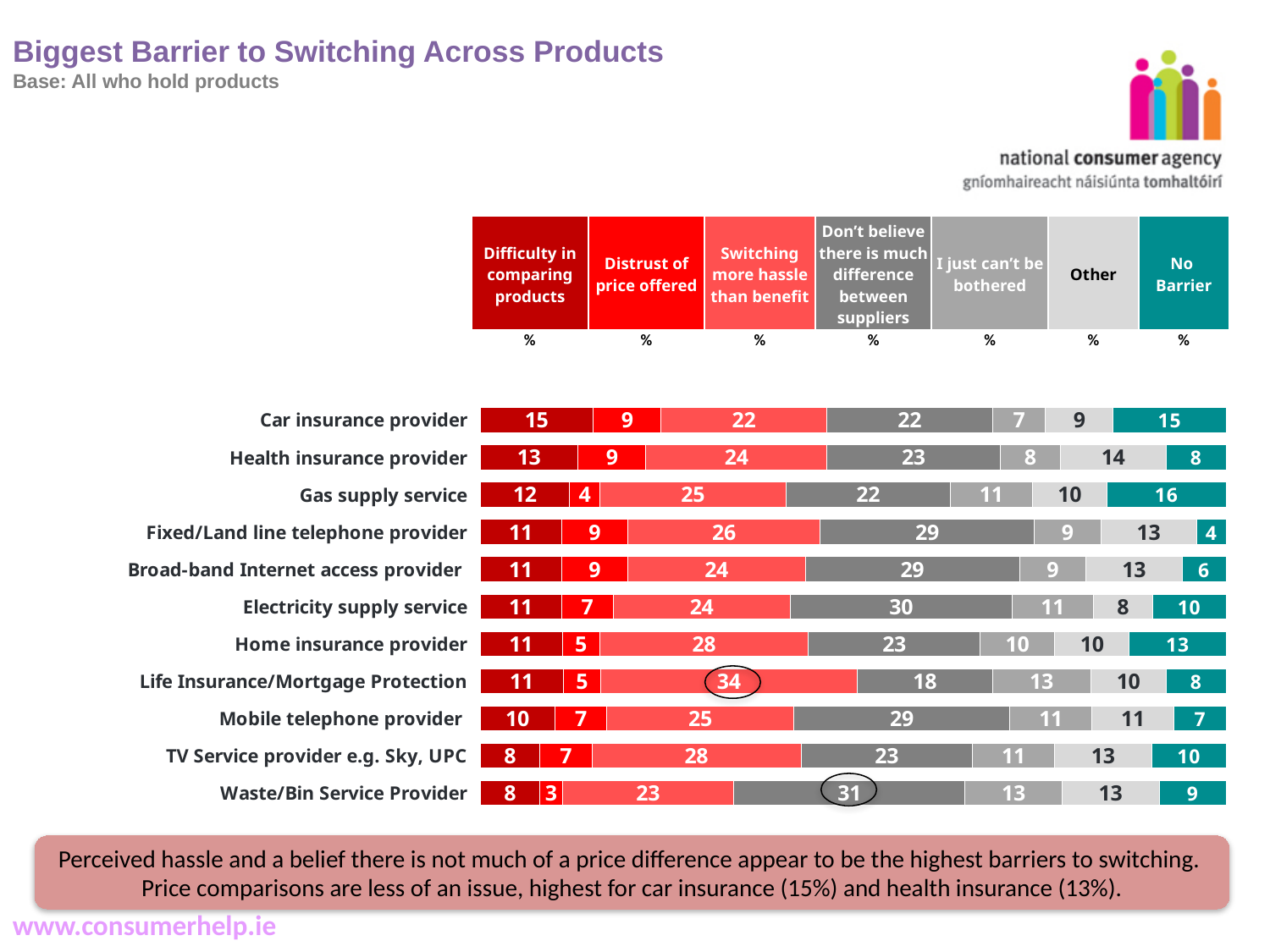
What is the difference between the 'Switching more hassle than benefit' values for Life Insurance/Mortgage Protection and Car insurance provider? 12 How many product categories are plotted in the chart? 11 What is the total of the stacked bar for Gas supply service? 100 What is the 'Don't believe there is much difference between suppliers' value for Waste/Bin Service Provider? 31 What is the title of the chart on the slide? Biggest Barrier to Switching Across Products Which is larger: the 'Other' value for Health insurance provider or for Electricity supply service? Health insurance provider What kind of chart is shown on the slide? Stacked bar chart How many series (barrier types) does the chart's legend list? 7 What is the 'Switching more hassle than benefit' value for Life Insurance/Mortgage Protection? 34 Which product has the lowest 'Distrust of price offered' value? Waste/Bin Service Provider What is the 'Difficulty in comparing products' value for Car insurance provider? 15 Which product has the highest 'No Barrier' value? Gas supply service